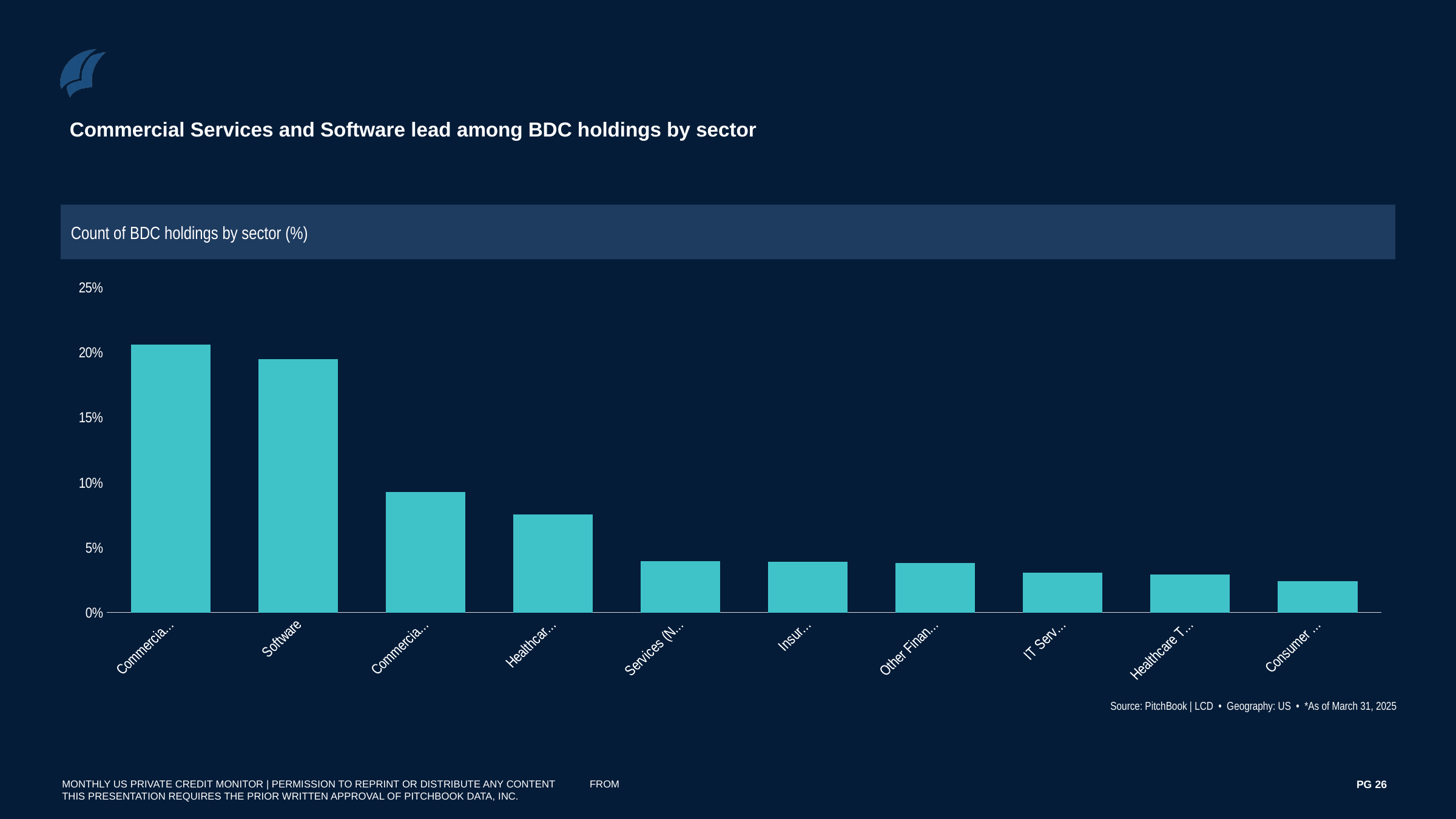
What kind of chart is shown on the slide? Bar chart Is the value for Software greater or less than 10%? greater Is the value for the last bar (Consumer ...) greater or less than 5%? less What is the highest value shown on the y axis? 25% How many sectors (bars) are plotted in the chart? 10 Which is larger, the value for Software or the value for the fourth bar (Healthcar...)? Software What is the title of the chart? Count of BDC holdings by sector (%) Is the value for the third bar (Commercia...) greater or less than 10%? less Do the bar values rise or fall moving from left to right along the x axis? Fall